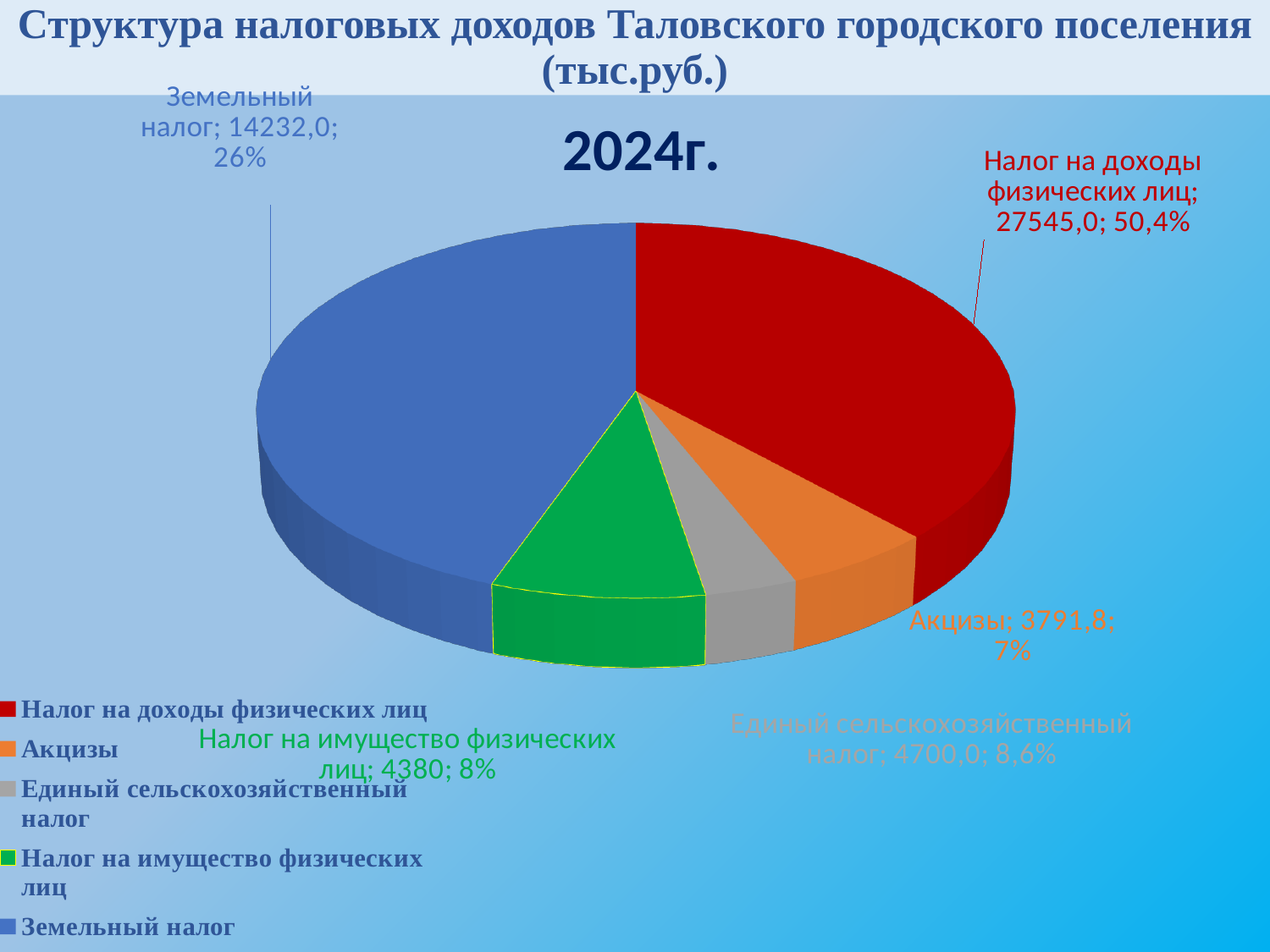
What is the value for Акцизы in the pie chart? 3791,8 What type of chart is shown on the slide? Pie chart What share of the pie does Единый сельскохозяйственный налог represent? 8,6% What is the difference between the values for Налог на доходы физических лиц and Земельный налог? 13313,0 What is the value for Налог на имущество физических лиц? 4380 What is the value for Налог на доходы физических лиц in the pie chart? 27545,0 Which year is shown above the pie chart? 2024г. What share of the pie does Земельный налог represent? 26% How many categories are shown in the pie chart? 5